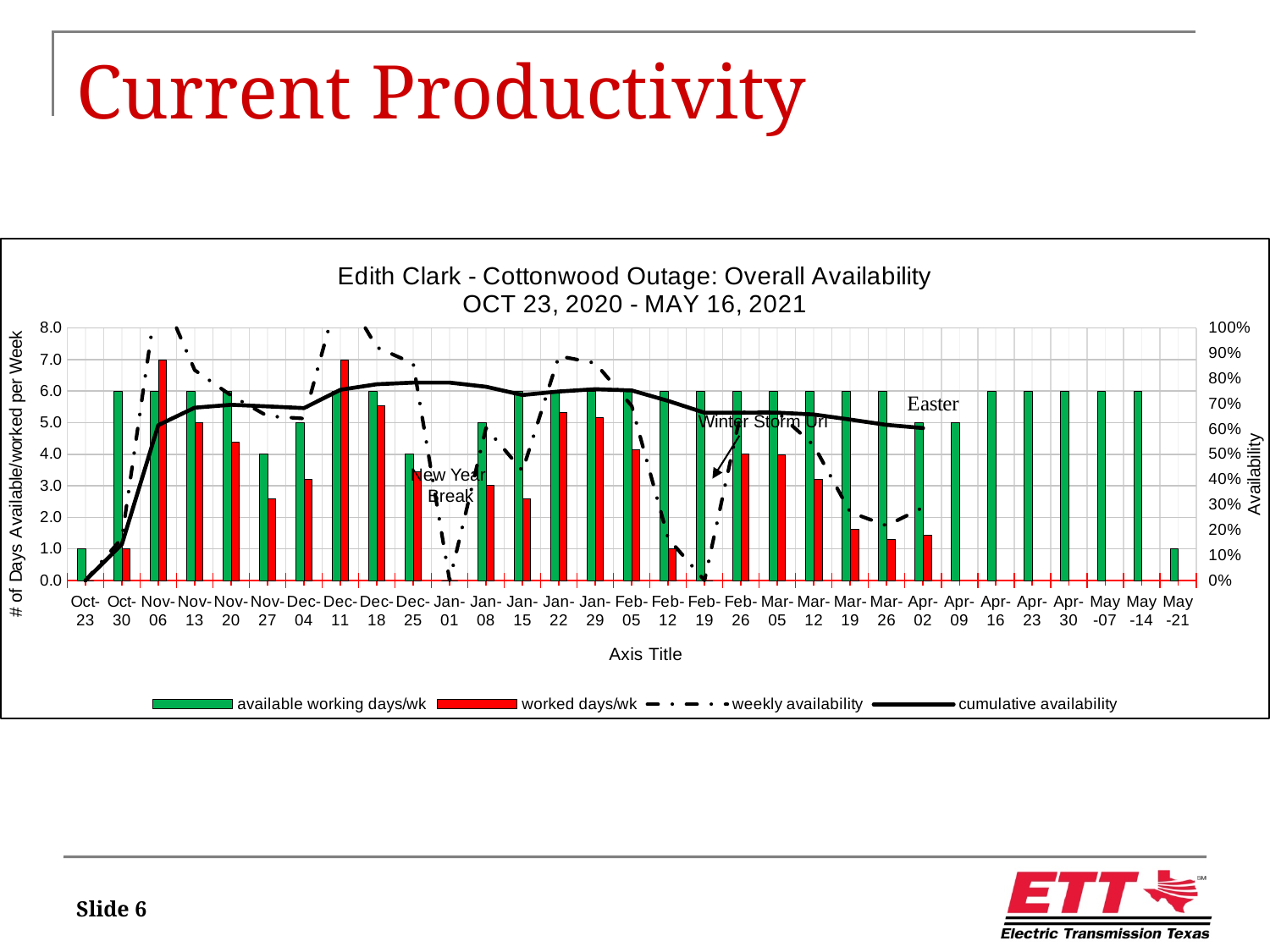
What is the value of worked days/wk for the week of Nov-06? 7.0 What is the value of worked days/wk for the week of Nov-13? 5.0 Is the value of worked days/wk for Jan-22 greater or less than 5.0? greater How many weekly categories are shown on the x axis? 31 What is the difference between worked days/wk for Nov-06 and worked days/wk for Nov-13? 2.0 What is the value of available working days/wk for the week of Nov-27? 4.0 What kind of chart is shown on the slide? Combined bar and line chart How many series does the chart legend list? 4 Which is larger: worked days/wk for Dec-11 or worked days/wk for Dec-18? Dec-11 What is the title of the chart? Edith Clark - Cottonwood Outage: Overall Availability OCT 23, 2020 - MAY 16, 2021 What is the value of available working days/wk for the week of Oct-23? 1.0 Is the value of worked days/wk for Mar-19 greater or less than 2.0? less